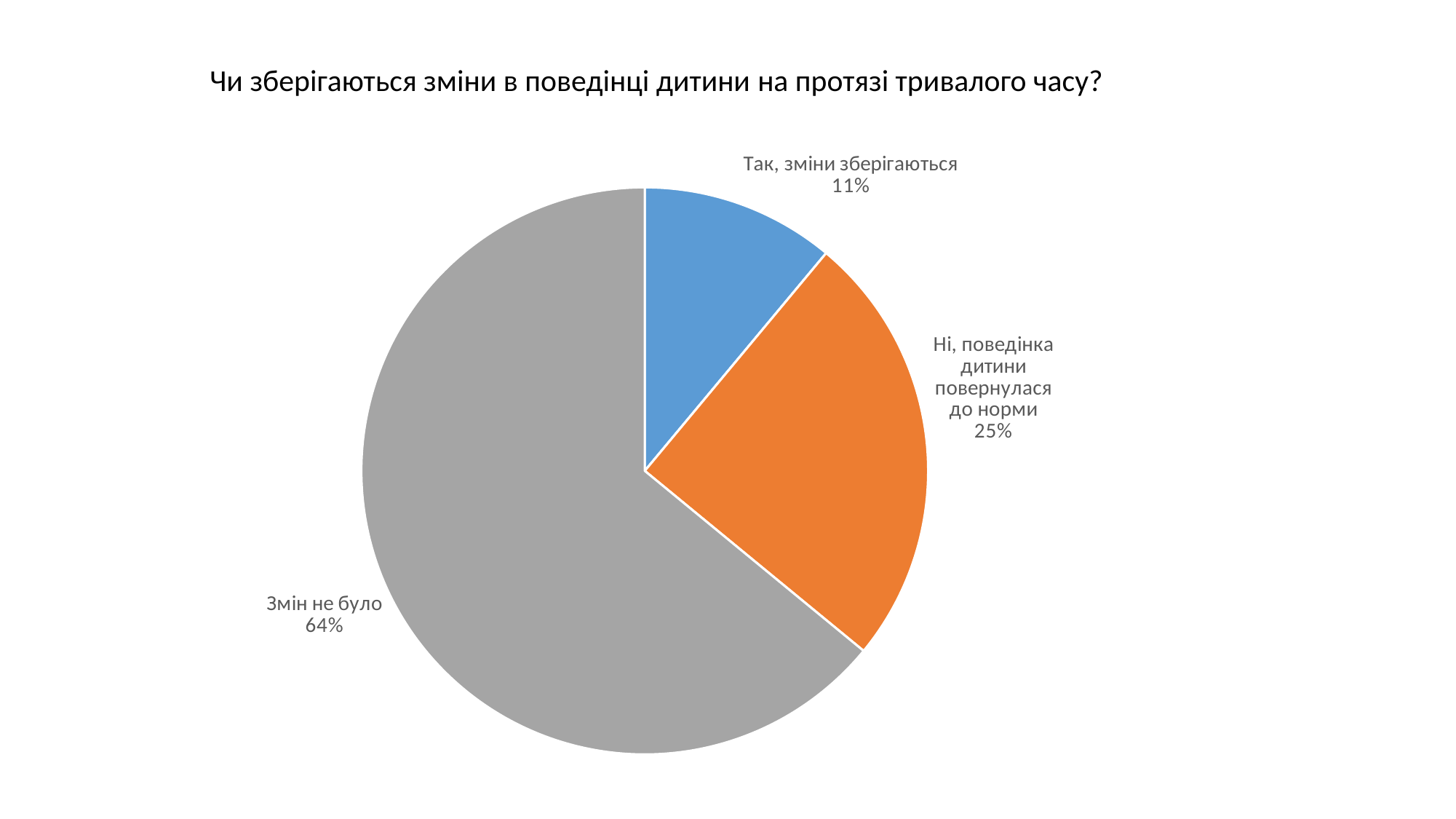
What share of the pie does "Змін не було" represent? 64% What is the difference in percentage points between "Ні, поведінка дитини повернулася до норми" and "Так, зміни зберігаються"? 14 How many slices does the pie chart have? 3 What colour is the slice for "Змін не було"? Grey What kind of chart is shown on the slide? Pie chart What is the title of the chart? Чи зберігаються зміни в поведінці дитини на протязі тривалого часу? What share of the pie does "Так, зміни зберігаються" represent? 11% What is the difference in percentage points between "Змін не було" and "Ні, поведінка дитини повернулася до норми"? 39 Which category has the smallest slice of the pie? Так, зміни зберігаються Which category has the largest slice of the pie? Змін не було What share of the pie does "Ні, поведінка дитини повернулася до норми" represent? 25% Which is larger: the slice for "Так, зміни зберігаються" or the slice for "Ні, поведінка дитини повернулася до норми"? Ні, поведінка дитини повернулася до норми